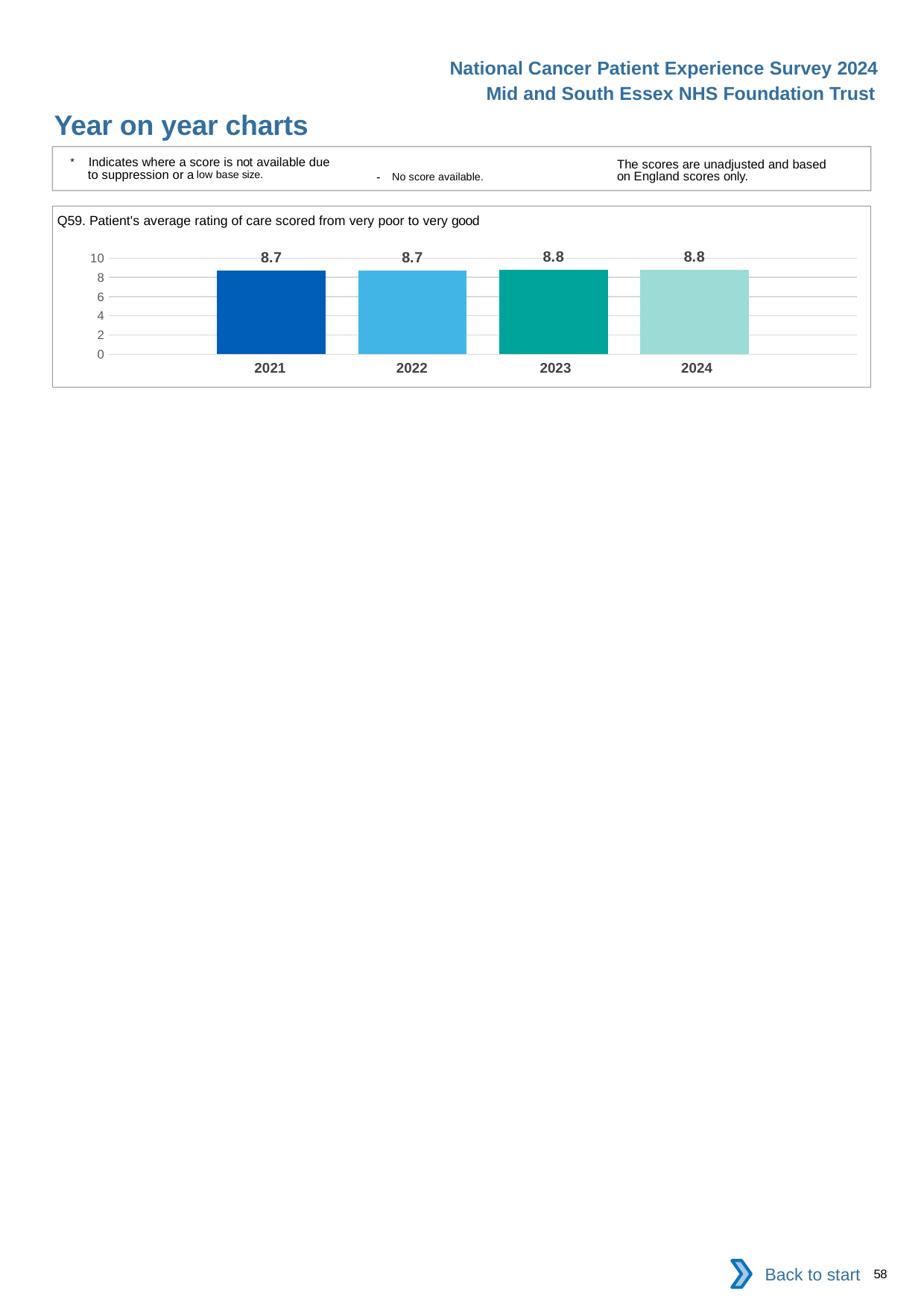
How many years are shown on the chart? 4 What is the value for 2022? 8.7 What is the value for 2024? 8.8 What is the title of the chart? Q59. Patient's average rating of care scored from very poor to very good What is the value for 2023? 8.8 What is the value for 2021? 8.7 What kind of chart is shown? bar chart Is the value for 2023 greater or less than 8? greater What is the difference between the values for 2024 and 2021? 0.1 Do the values rise or fall from 2021 to 2024? rise What is the highest value shown on the y axis? 10